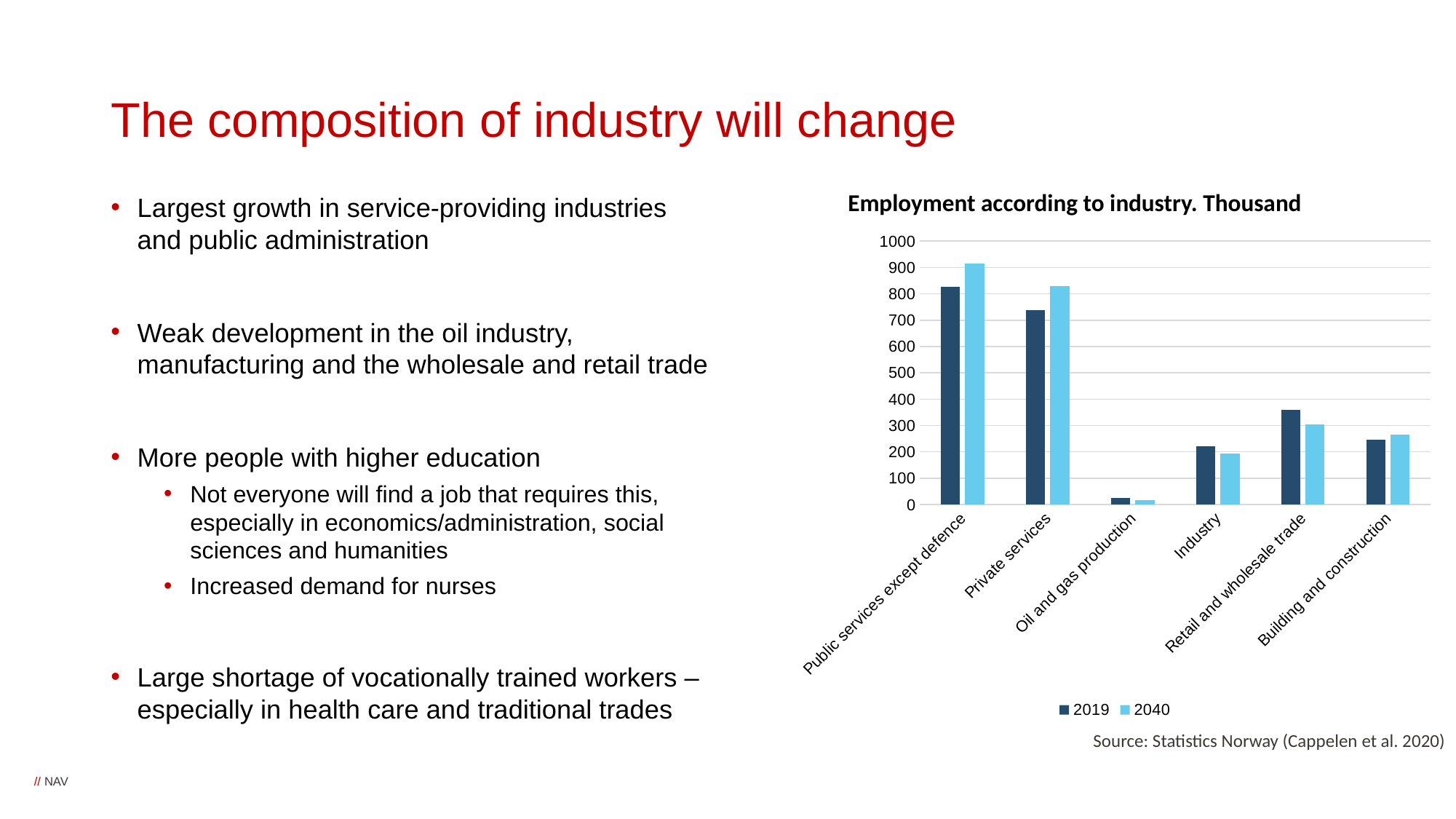
Which series is shown in light blue in the legend? 2040 How many industry categories are shown on the x axis? 6 Is the 2019 value for Private services greater or less than 800? less For Industry, which year has the larger value, 2019 or 2040? 2019 Is the 2040 value for Public services except defence greater or less than 900? greater Which industry has the highest employment in 2040? Public services except defence How many series does the chart legend list? 2 Which industry has the lowest employment in 2019? Oil and gas production What kind of chart is shown on the slide? bar chart Is the 2019 value for Retail and wholesale trade greater or less than 300? greater What is the title of the chart? Employment according to industry. Thousand For Building and construction, which year has the larger value, 2019 or 2040? 2040